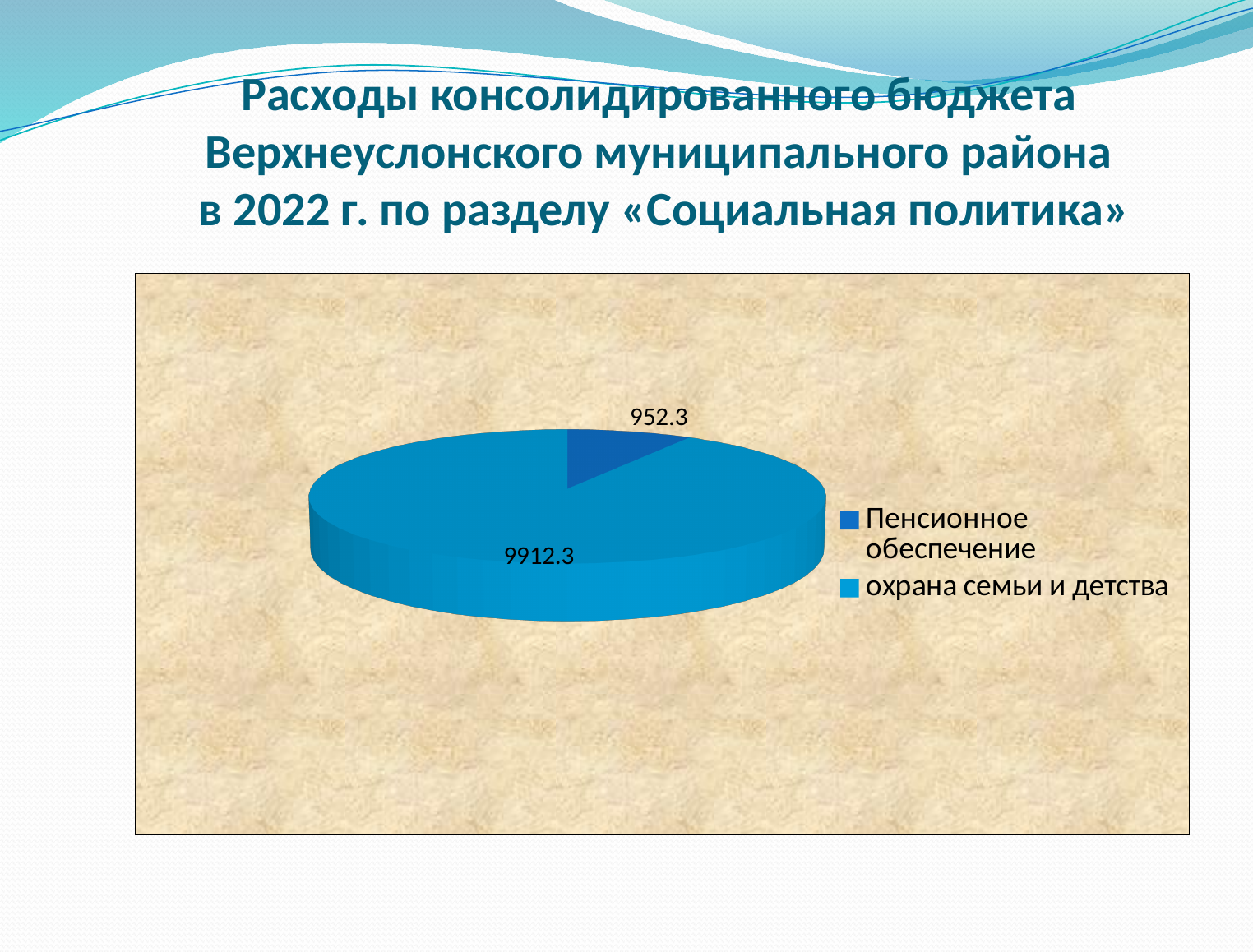
Which category has the largest slice of the pie? охрана семьи и детства What is the total of all slices in the pie chart? 10864.6 Which is larger: the value for Пенсионное обеспечение or the value for охрана семьи и детства? охрана семьи и детства How many slices does the pie chart have? 2 What is the value for Пенсионное обеспечение? 952.3 Which legend entry is shown in the darker blue colour? Пенсионное обеспечение What is the difference between the values for охрана семьи и детства and Пенсионное обеспечение? 8960.0 What is the value for охрана семьи и детства? 9912.3 What type of chart is shown on the slide? Pie chart What share of the pie does Пенсионное обеспечение represent, to one decimal place? 8.8% Which category has the smallest slice of the pie? Пенсионное обеспечение How many entries does the legend list? 2